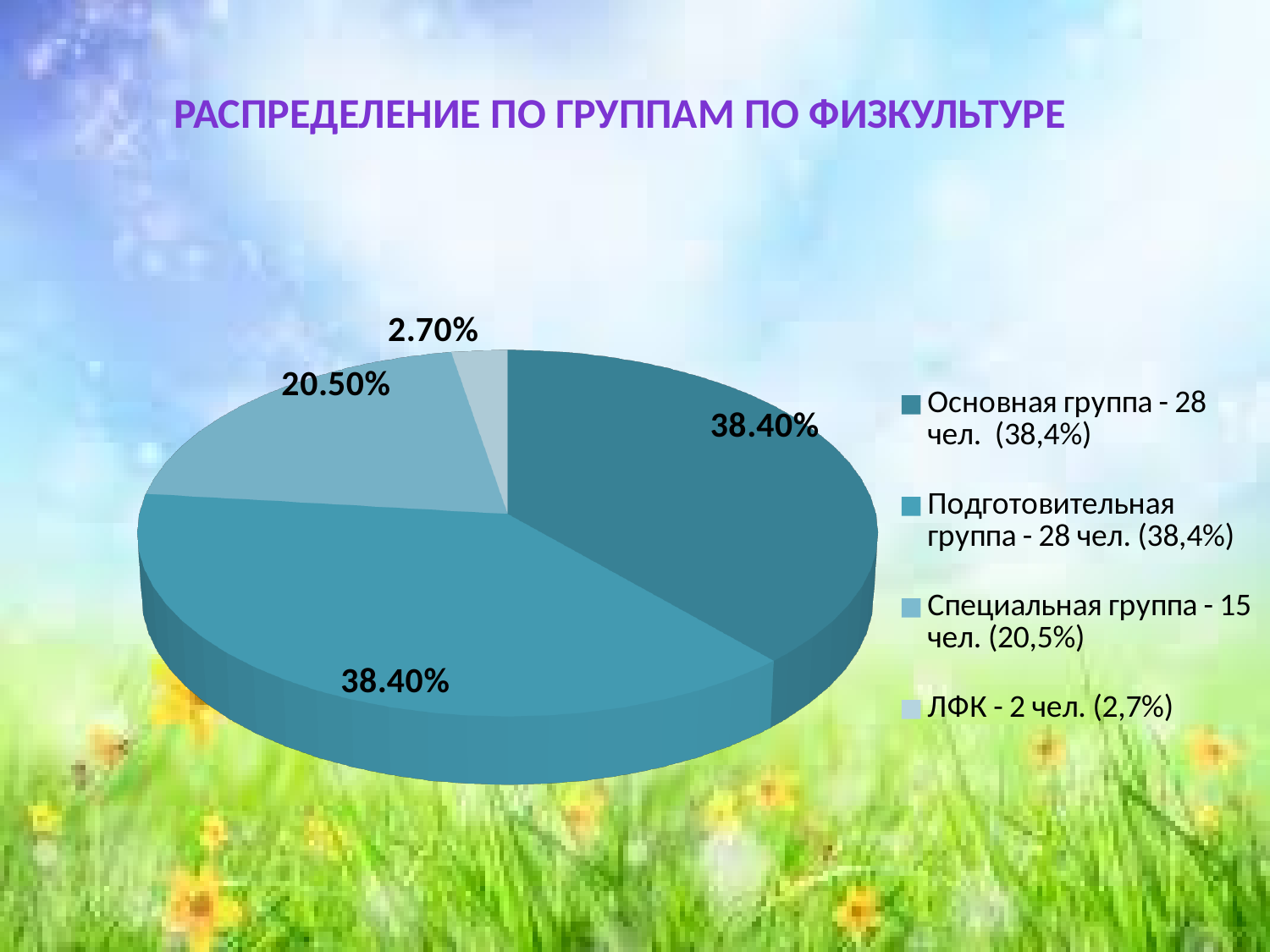
What percentage is shown for the Специальная группа slice? 20.50% What is the difference in percentage points between the Подготовительная группа slice and the Специальная группа slice? 17.90% According to the legend, how many people are in the Специальная группа? 15 чел. What percentage is shown for the ЛФК slice? 2.70% Which group has the smallest slice of the pie? ЛФК Which slice is larger: Специальная группа or ЛФК? Специальная группа How many slices does the pie chart have? 4 What is the title of the chart? РАСПРЕДЕЛЕНИЕ ПО ГРУППАМ ПО ФИЗКУЛЬТУРЕ How many entries does the legend list? 4 According to the legend, how many people are in the ЛФК group? 2 чел. What kind of chart is shown on the slide? pie chart What percentage is shown for the Основная группа slice? 38.40%